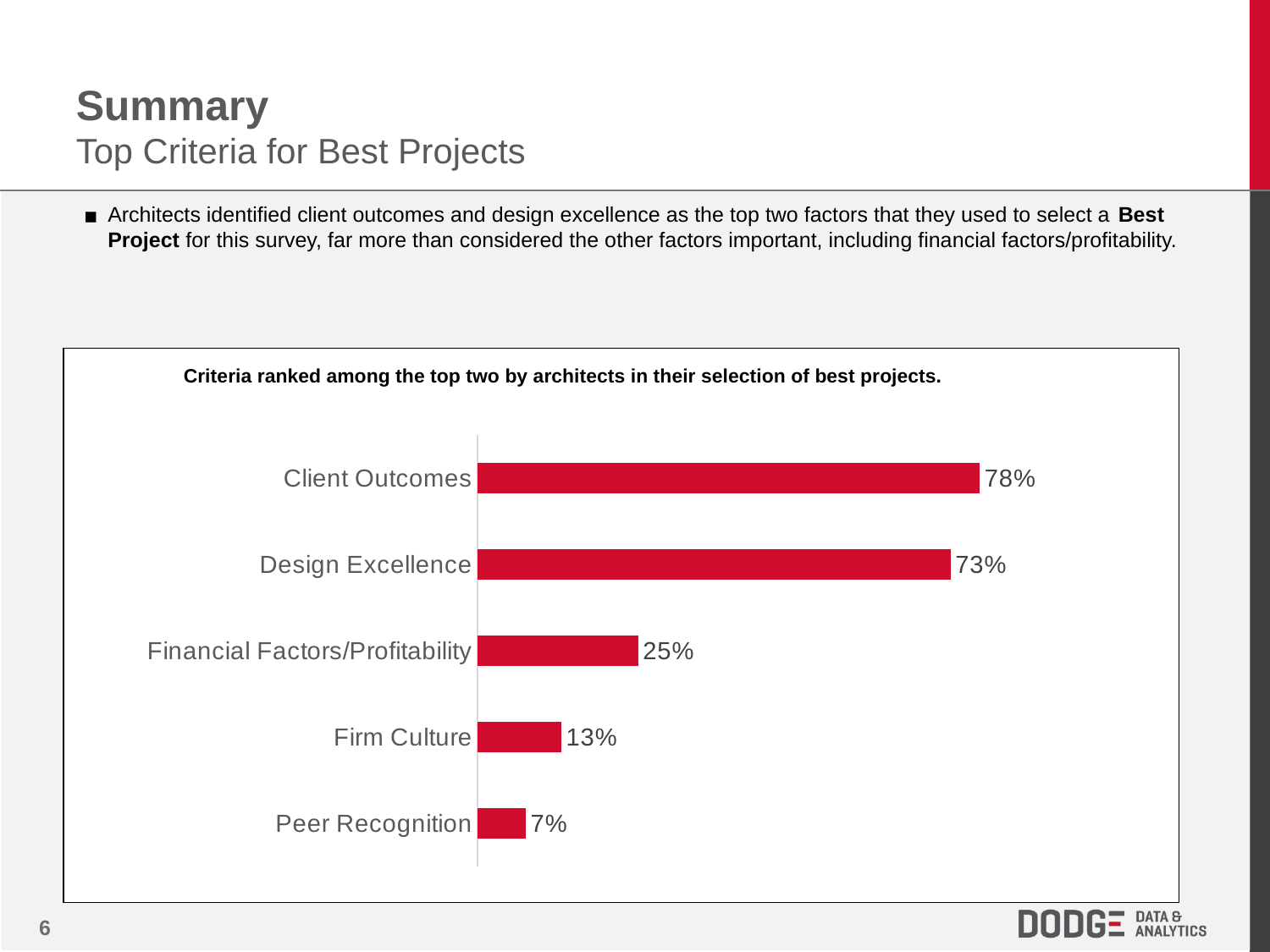
What is the difference between the values for Financial Factors/Profitability and Firm Culture? 12% How many criteria are shown in the chart? 5 What is the value shown for Financial Factors/Profitability? 25% Which criterion has the lowest value in the chart? Peer Recognition What is the value shown for Firm Culture? 13% Which has a larger value, Financial Factors/Profitability or Firm Culture? Financial Factors/Profitability Which criterion has the highest value in the chart? Client Outcomes What is the value shown for Peer Recognition? 7% What is the difference between the values for Client Outcomes and Design Excellence? 5% What type of chart is shown on the slide? Bar chart What percentage of architects ranked Client Outcomes among their top two criteria? 78% What is the value shown for Design Excellence? 73%